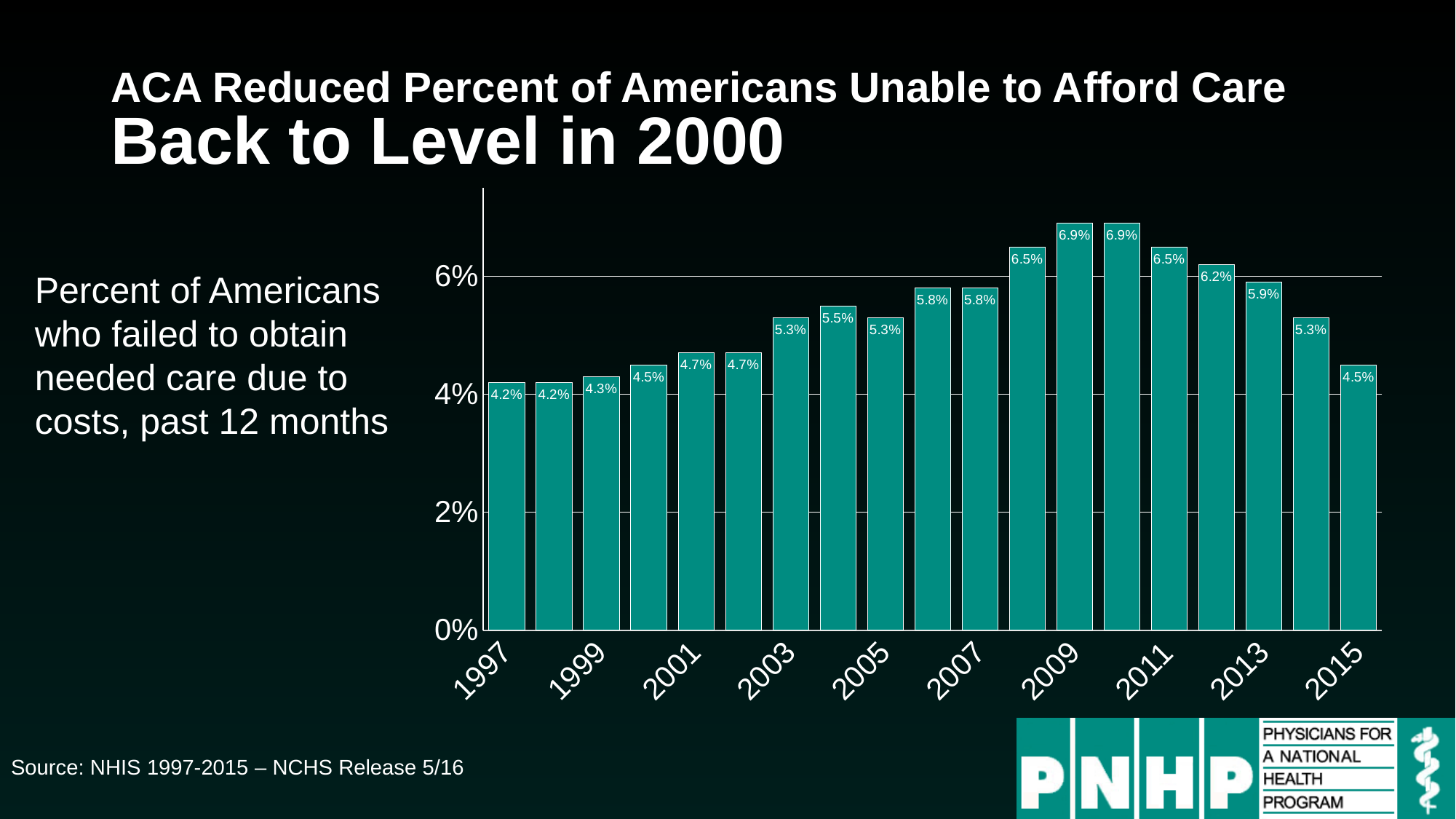
What is the value for 2013? 5.9% What is the value for 2009? 6.9% What is the value for 2015? 4.5% Is the value for 2007 greater or less than 6%? less What is the value for 1997? 4.2% What is the highest value shown on the chart? 6.9% What is the lowest value shown on the chart? 4.2% How many bars are shown on the chart? 19 Which is larger, the value for 2011 or the value for 2013? 2011 Do the values rise or fall from 2009 to 2015? fall What kind of chart is shown on the slide? bar chart What is the difference between the values for 2009 and 2015? 2.4%